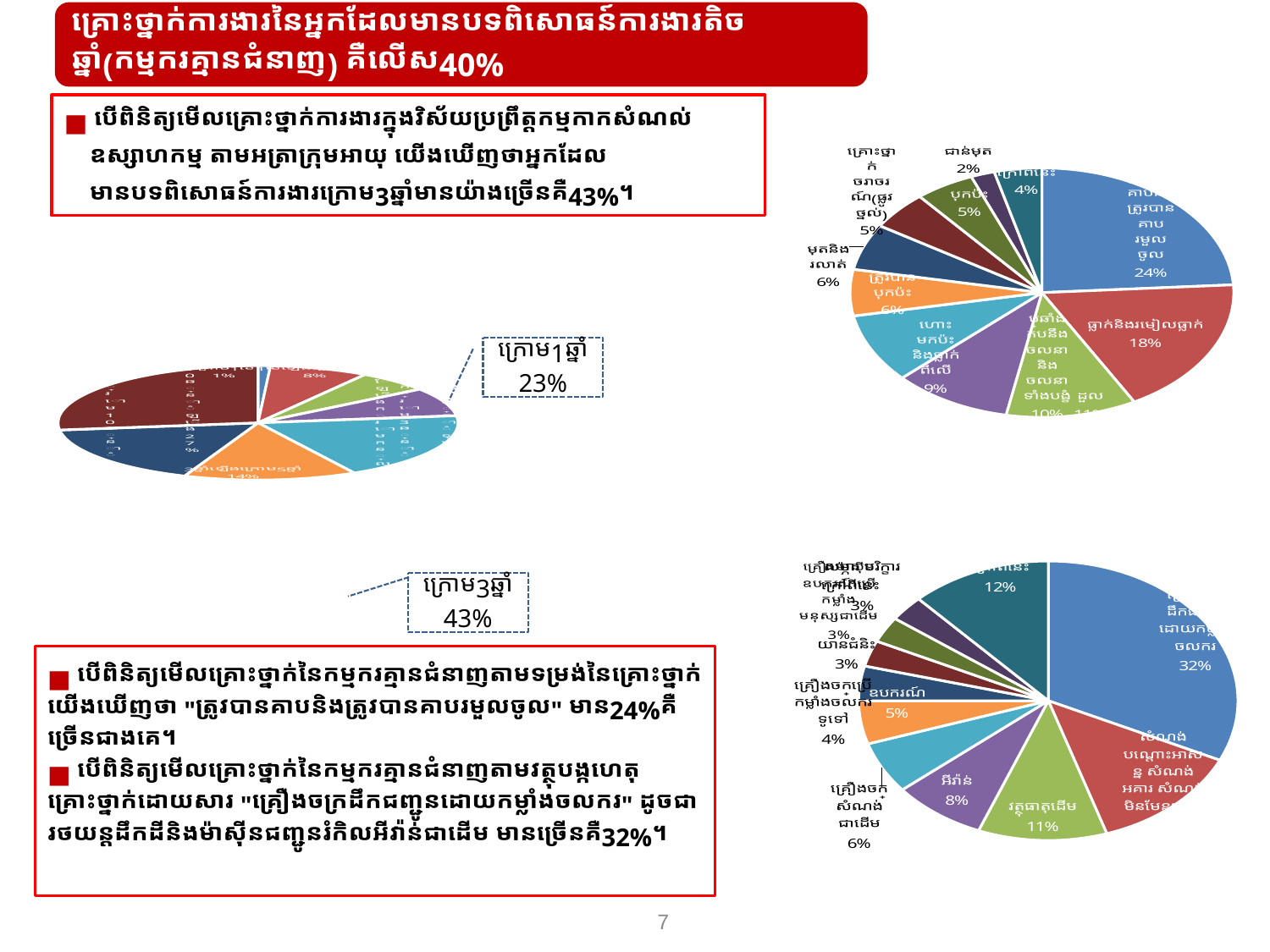
What kind of chart is the top-right chart on the slide? Pie chart In the bottom-right pie chart, what is the share of the slice labelled គ្រឿងចក្រដឹកជញ្ជូនដោយកម្លាំងចលករ? 32% In the top-right pie chart, what is the difference between the 24% slice and the 18% slice? 6 percentage points How many pie charts are shown on the slide? 3 In the left pie chart, what share is shown in the callout for ក្រោម3ឆ្នាំ? 43% In the top-right pie chart, what is the share of the largest slice? 24% In the bottom-right pie chart, what is the share of the slice labelled វត្ថុធាតុដើម? 11% In the top-right pie chart, which slice is the smallest? ជាន់មុត (2%) In the bottom-right pie chart, which is larger: the slice labelled អីវ៉ាន់ or the slice labelled ឧបករណ៍? អីវ៉ាន់ (8%) In the top-right pie chart, what is the share of the slice labelled ហោះមកប៉ះនិងធ្លាក់ពីលើ? 9%